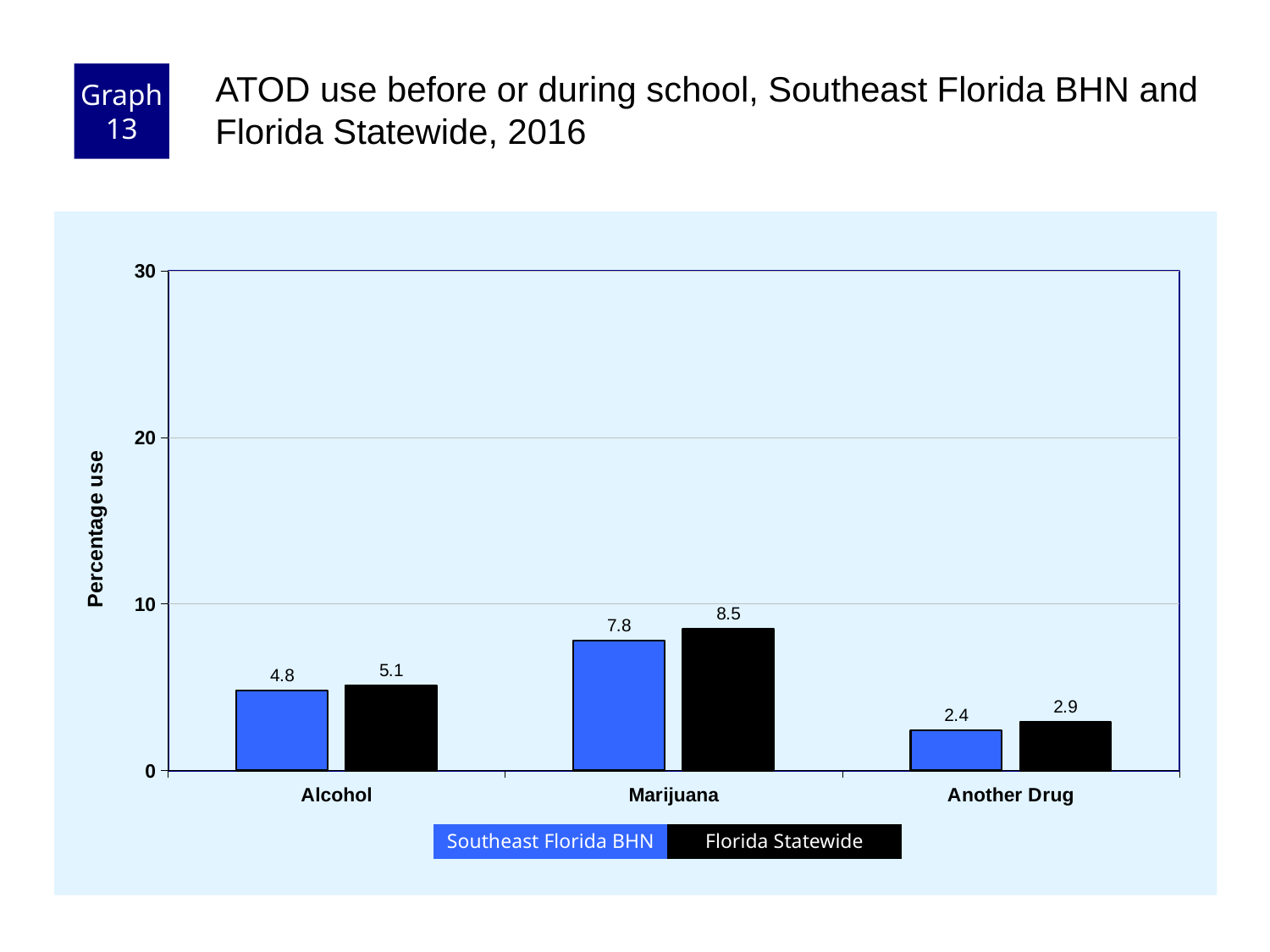
Which category has the lowest Southeast Florida BHN value? Another Drug What is the Florida Statewide value for Alcohol? 5.1 Is the Florida Statewide value for Marijuana greater or less than 10? less Which category has the highest Florida Statewide value? Marijuana What is the difference between the Florida Statewide and Southeast Florida BHN values for Marijuana? 0.7 What kind of chart is shown on the slide? bar chart What is the Southeast Florida BHN value for Another Drug? 2.4 What is the Florida Statewide value for Marijuana? 8.5 How many series does the legend list? 2 Which is larger for Another Drug: Southeast Florida BHN or Florida Statewide? Florida Statewide What is the Southeast Florida BHN value for Alcohol? 4.8 How many categories are shown on the x axis? 3